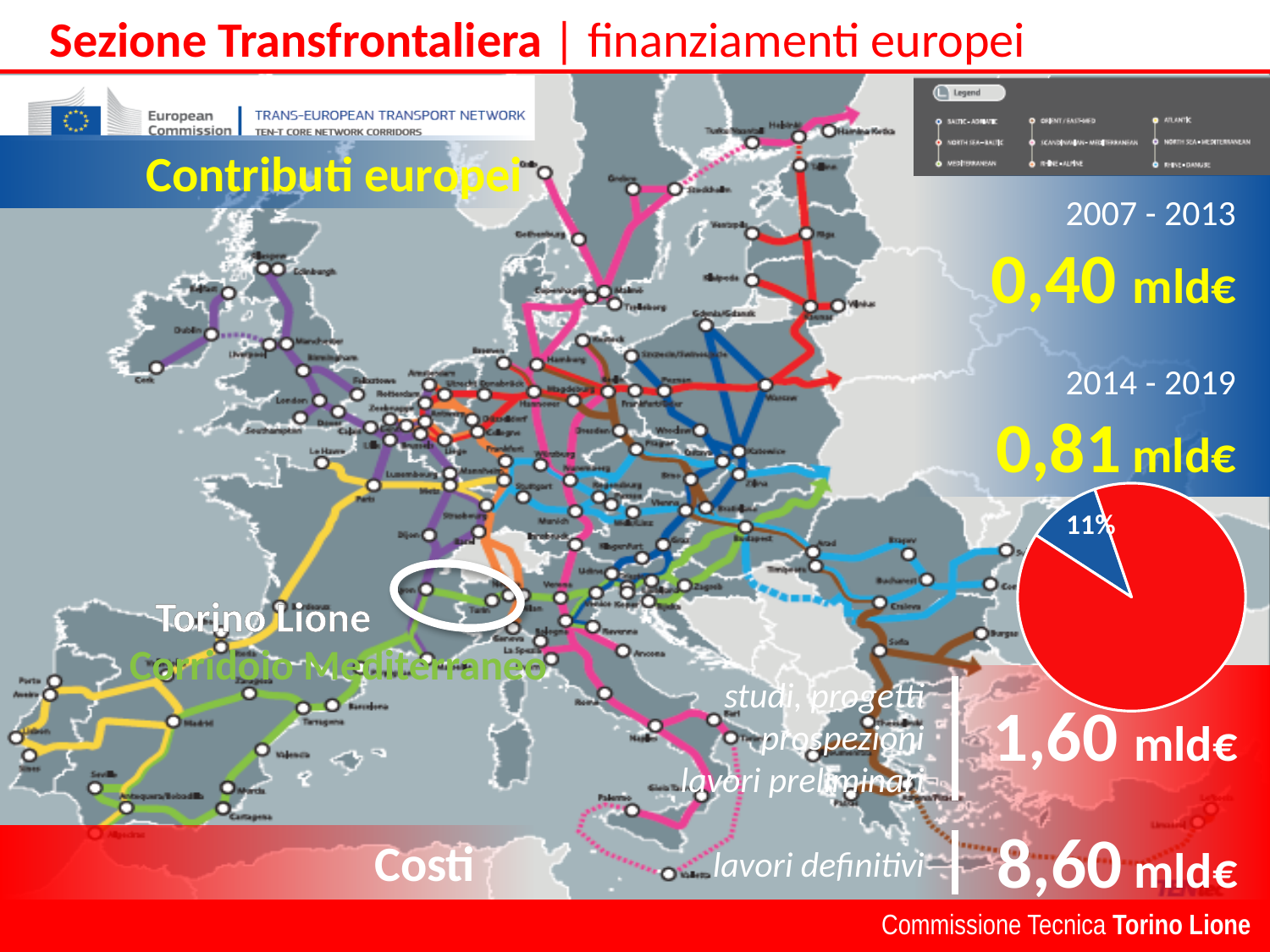
How many slices does the pie chart have? 2 What percentage is printed on the blue slice of the pie chart? 11% Which slice of the pie chart is larger, the red one or the blue one? red What colour is the slice labelled 11% in the pie chart? blue What kind of chart is shown on the right side of the slide? pie chart Is the blue slice of the pie chart greater or less than half of the pie? less Which slice of the pie chart is the smallest? the blue slice (11%)